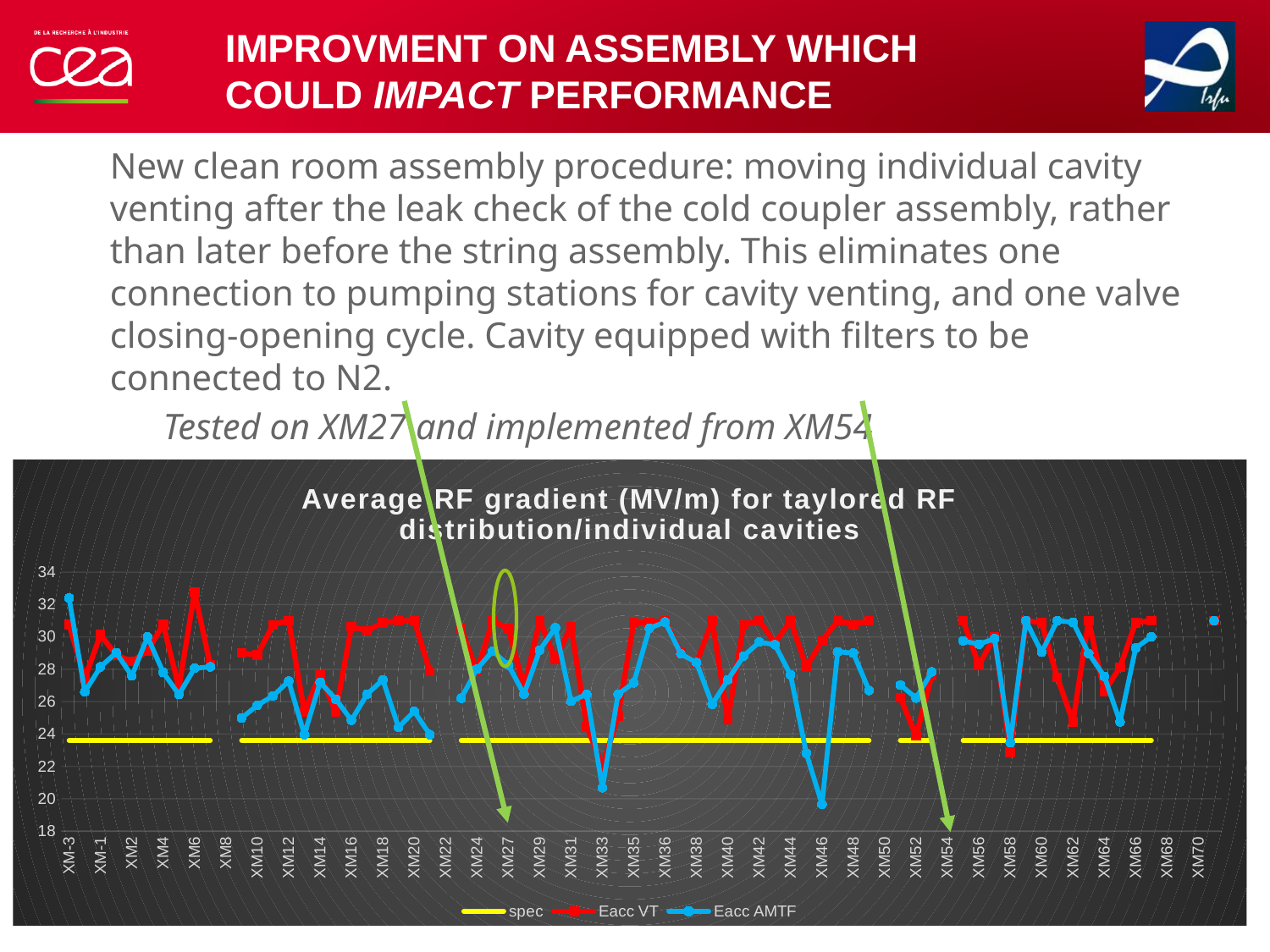
Which series is drawn in yellow? spec Is the Eacc AMTF value for XM46 greater or less than 22? less How many series does the legend list? 3 Is the value of the spec series greater or less than 24? less Is the Eacc AMTF value for XM-3 greater or less than 30? greater What kind of chart is shown on the slide? line chart At XM10, which series has the larger value, Eacc VT or Eacc AMTF? Eacc VT What is the title of the chart? Average RF gradient (MV/m) for taylored RF distribution/individual cavities At XM46, which series has the larger value, Eacc VT or Eacc AMTF? Eacc VT Does the spec series rise, fall, or stay flat along the x axis? stays flat